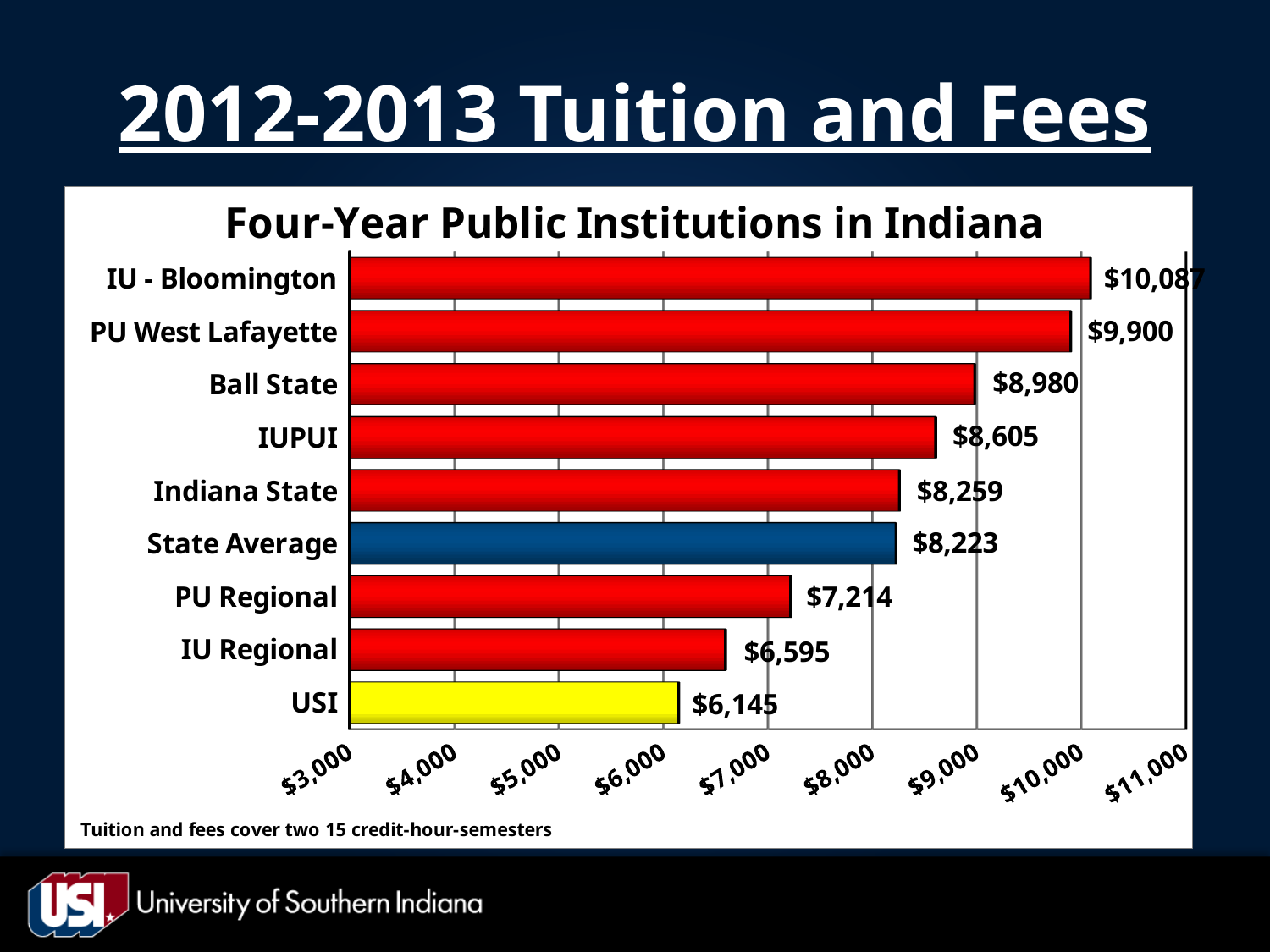
What is the difference between the tuition and fees for IU - Bloomington and USI? $3,942 What is the tuition and fees value for Ball State? $8,980 What is the difference between the tuition and fees for PU Regional and IU Regional? $619 What is the tuition and fees value for USI? $6,145 Is the tuition and fees value for PU West Lafayette greater or less than $9,000? greater How many institutions or categories are shown in the chart? 9 What is the State Average tuition and fees value? $8,223 Which has higher tuition and fees, IUPUI or Indiana State? IUPUI What kind of chart is shown on the slide? bar chart What is the title of the chart? Four-Year Public Institutions in Indiana Which institution has the highest tuition and fees? IU - Bloomington Which institution has the lowest tuition and fees? USI